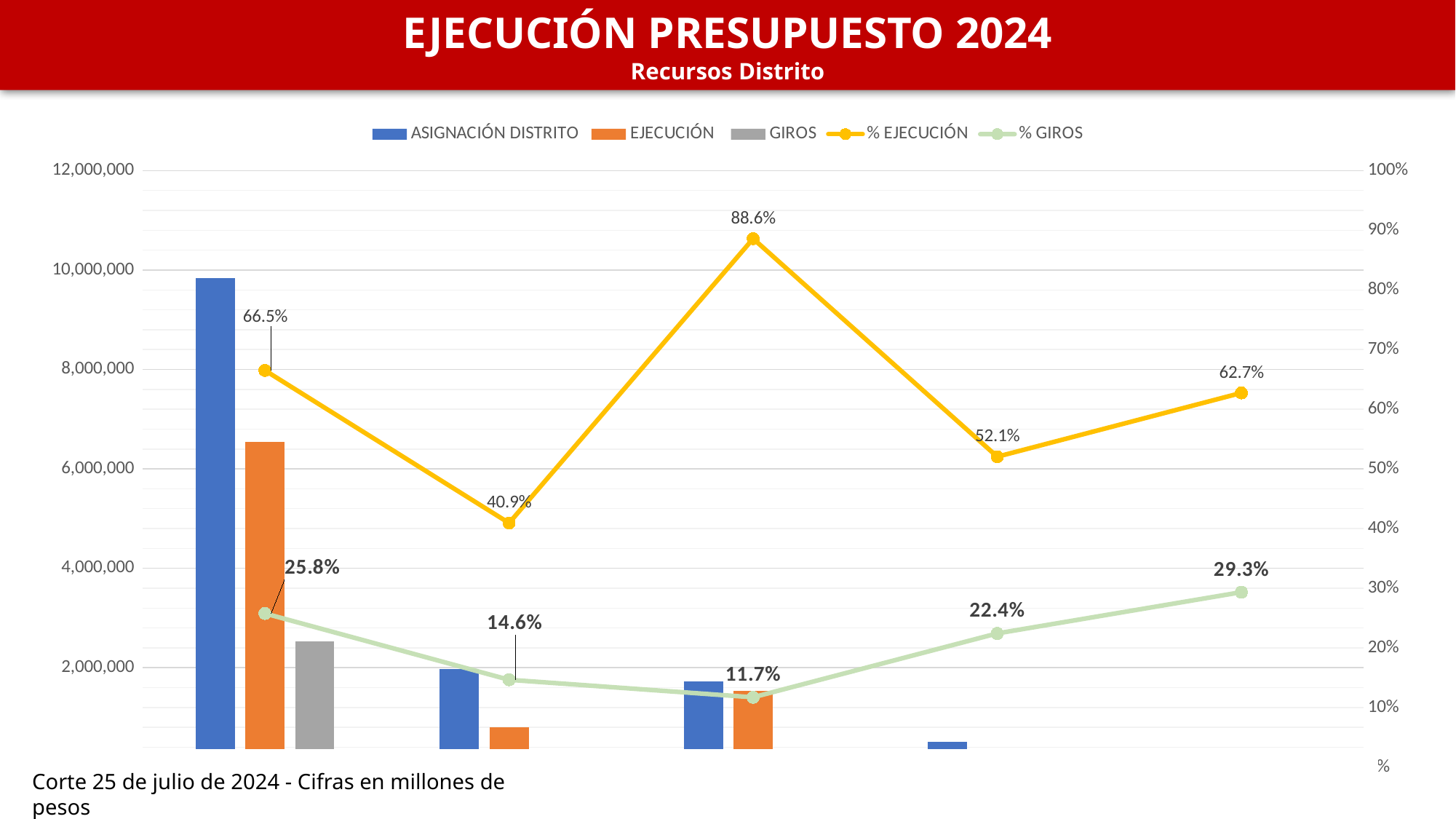
How many series does the legend list? 5 How many data points does the % EJECUCIÓN line have? 5 Which is larger at the first point: the % EJECUCIÓN value or the % GIROS value? % EJECUCIÓN (66.5%) What is the difference between the highest and lowest % EJECUCIÓN values? 47.7 percentage points What is the % GIROS value at the fourth point of the line? 22.4% What is the highest value shown on the % GIROS line? 29.3% What is the % EJECUCIÓN value at the first (leftmost) point of the line? 66.5% What is the highest value shown on the % EJECUCIÓN line? 88.6% What is the lowest value shown on the % EJECUCIÓN line? 40.9% Is the value of the first (leftmost) ASIGNACIÓN DISTRITO bar greater or less than 8,000,000? greater What kind of chart is shown on the slide? Combined bar and line chart What is the lowest value shown on the % GIROS line? 11.7%